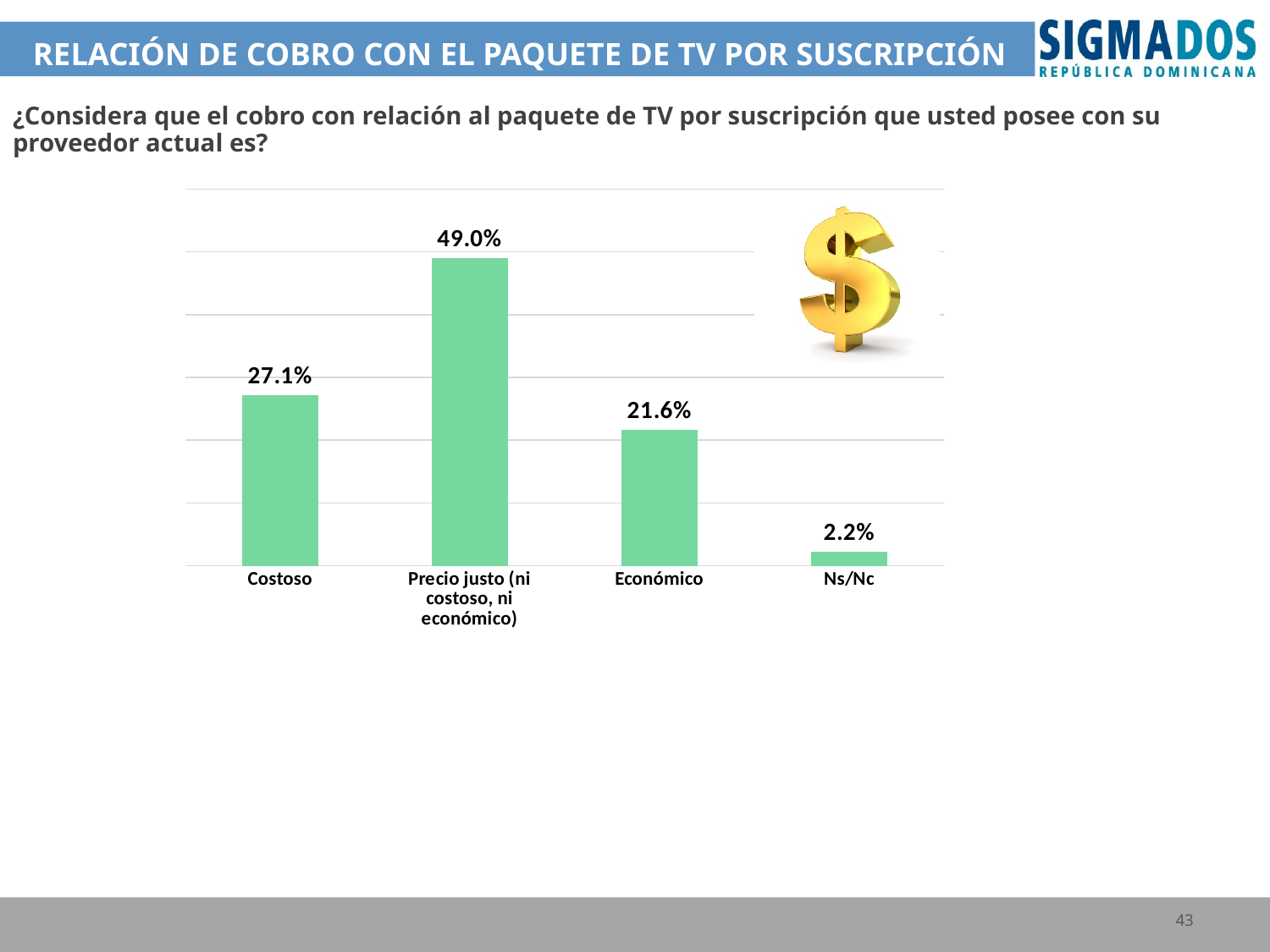
What colour are the bars in the chart? Green What is the value for 'Ns/Nc'? 2.2% What percentage is shown for 'Económico'? 21.6% What is the difference between the values for 'Precio justo (ni costoso, ni económico)' and 'Costoso'? 21.9% What type of chart is shown on the slide? Bar chart Which is larger, the value for 'Costoso' or the value for 'Económico'? Costoso What is the difference between the values for 'Costoso' and 'Económico'? 5.5% What is the value shown for 'Precio justo (ni costoso, ni económico)'? 49.0% What percentage of respondents consider the charge for their TV subscription package to be 'Costoso'? 27.1% Which category has the highest value? Precio justo (ni costoso, ni económico) Which category has the lowest value? Ns/Nc How many categories are shown in the chart? 4